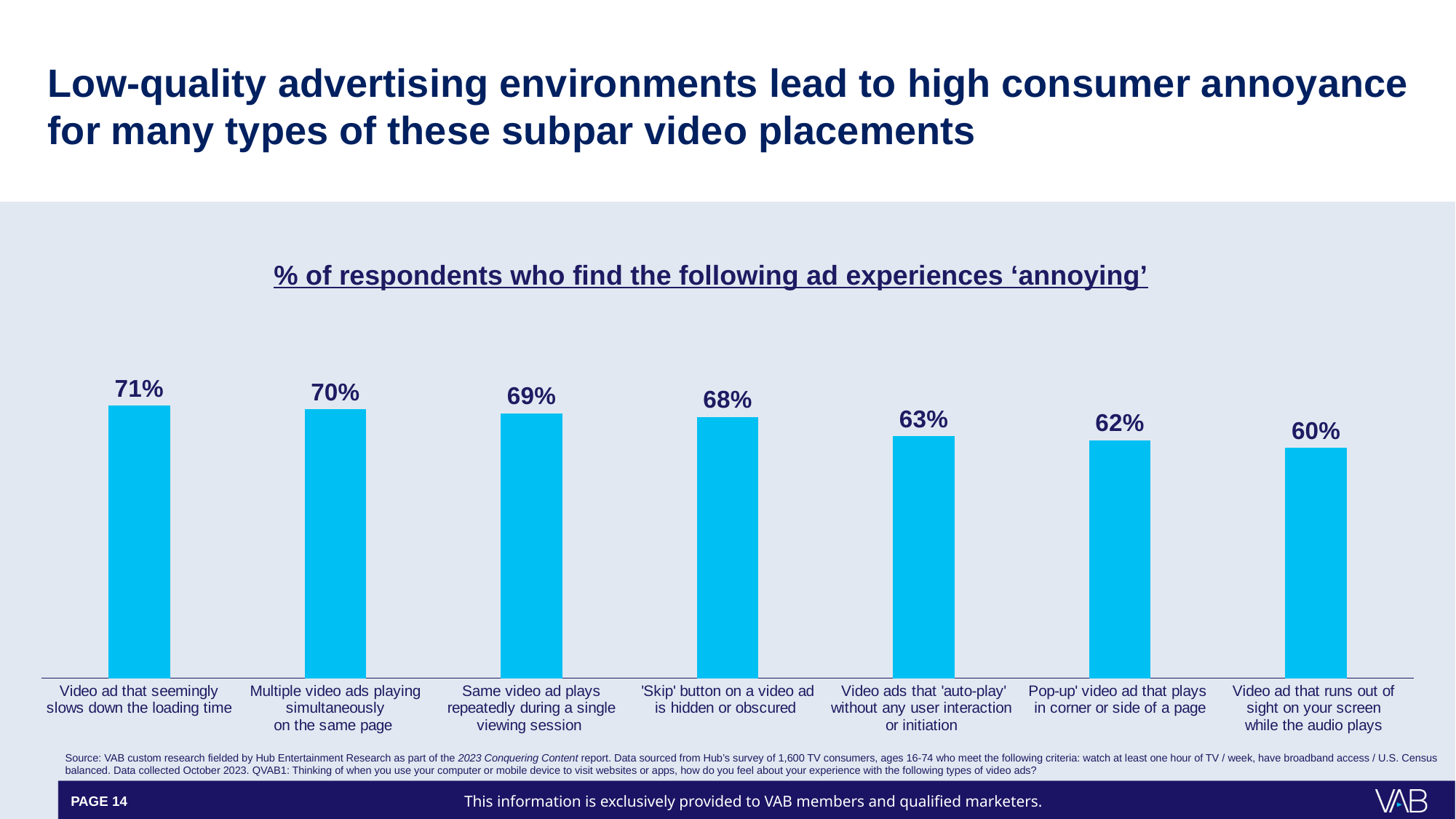
What percentage of respondents find a 'Skip' button on a video ad that is hidden or obscured annoying? 68% Which has a higher percentage: 'Multiple video ads playing simultaneously on the same page' or 'Video ads that auto-play without any user interaction or initiation'? Multiple video ads playing simultaneously on the same page What is the difference in percentage points between 'Same video ad plays repeatedly during a single viewing session' and 'Video ads that auto-play without any user interaction or initiation'? 6 What type of chart is shown on the slide? Bar chart What is the difference in percentage points between the highest and lowest values shown in the chart? 11 Which ad experience has the lowest share of respondents finding it annoying? Video ad that runs out of sight on your screen while the audio plays Do the values rise or fall moving from left to right across the chart? Fall Which ad experience has the highest share of respondents finding it annoying? Video ad that seemingly slows down the loading time How many ad experiences are shown in the chart? 7 What percentage of respondents find a pop-up video ad that plays in the corner or side of a page annoying? 62% What is the title of the chart? % of respondents who find the following ad experiences 'annoying' What percentage of respondents find a video ad that seemingly slows down the loading time annoying? 71%